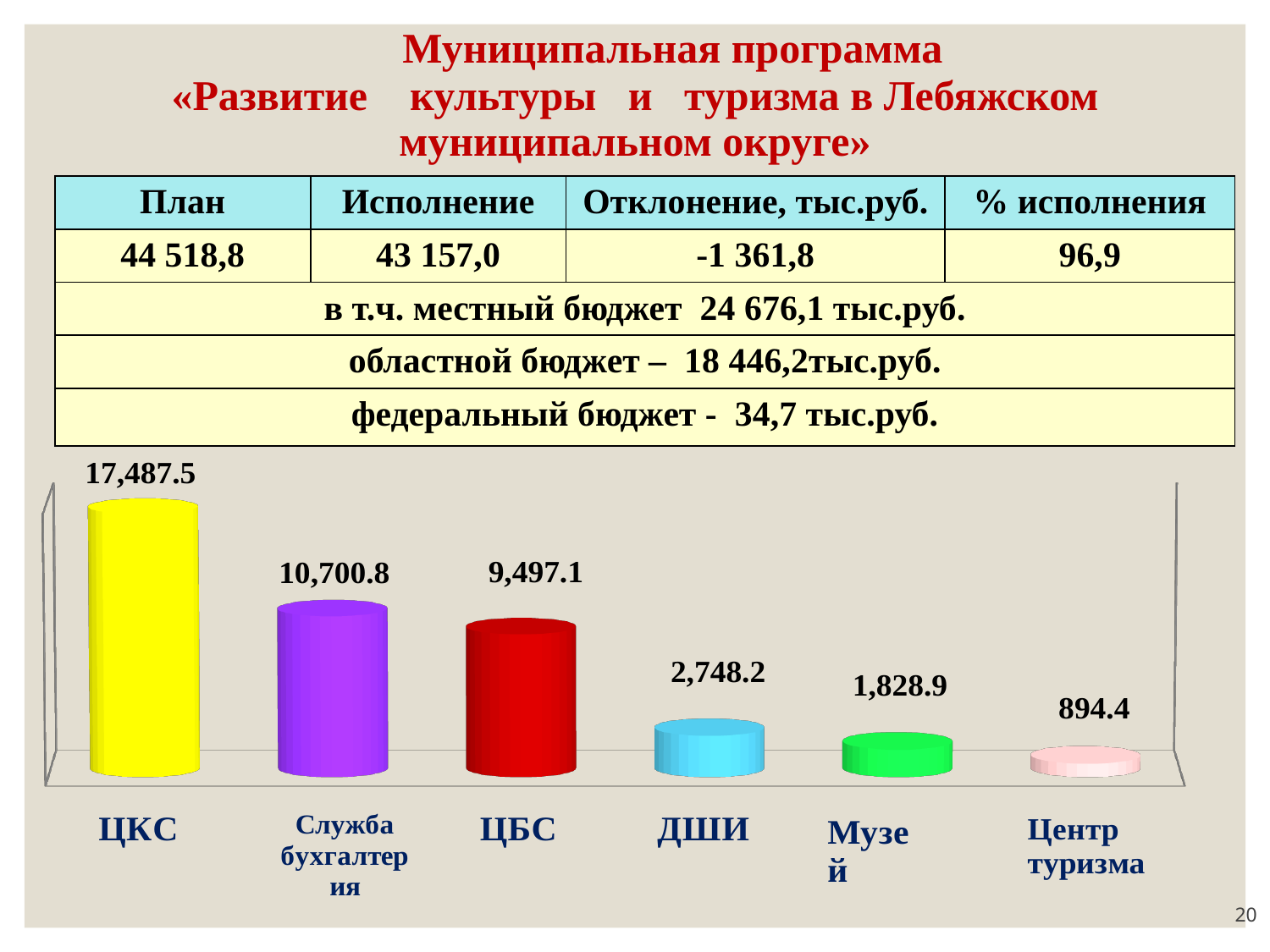
How many categories are shown in the chart? 6 What is the value shown for ДШИ? 2,748.2 What is the value shown for Центр туризма? 894.4 Which category has the highest value? ЦКС What is the value shown for Музей? 1,828.9 What is the value shown for Служба бухгалтерия? 10,700.8 What kind of chart is shown on the slide? Bar chart Which category has the lowest value? Центр туризма What is the value shown for ЦКС? 17,487.5 Which is larger, the value for ДШИ or the value for Музей? ДШИ What is the difference between the values for ЦКС and Служба бухгалтерия? 6,786.7 What is the value shown for ЦБС? 9,497.1